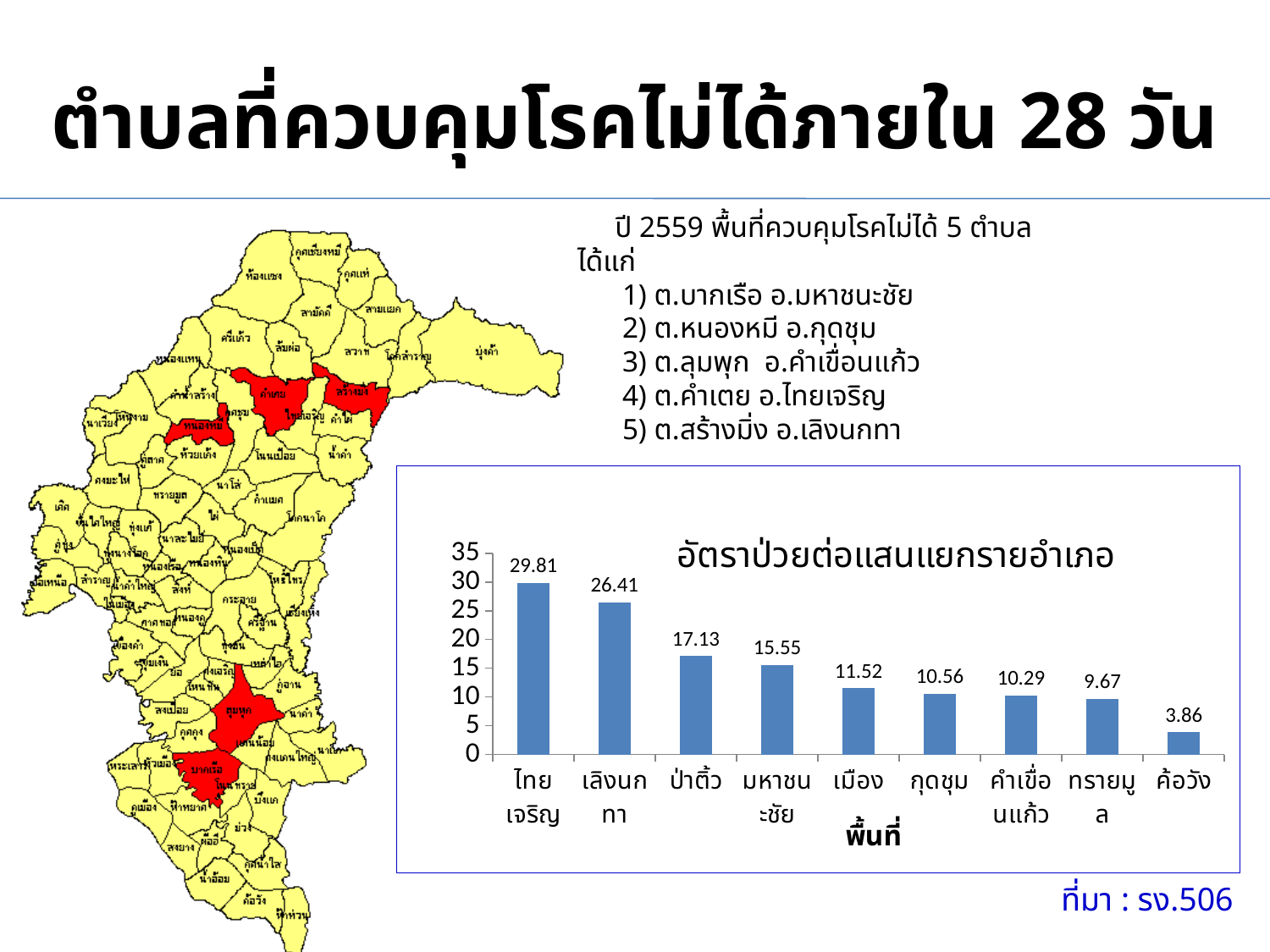
What kind of chart is shown on the slide? bar chart Is the value for กุดชุม greater or less than 15? less What is the value for มหาชนะชัย in the chart? 15.55 What is the title of the chart? อัตราป่วยต่อแสนแยกรายอำเภอ How many districts are shown in the chart? 9 What is the difference between the values for ไทยเจริญ and เลิงนกทา? 3.40 Which is larger, the value for ป่าติ้ว or the value for เมือง? ป่าติ้ว Do the values rise or fall from left to right along the x axis? fall What is the value for ค้อวัง in the chart? 3.86 What is the value for ไทยเจริญ in the chart? 29.81 Which district has the highest value in the chart? ไทยเจริญ Which district has the lowest value in the chart? ค้อวัง